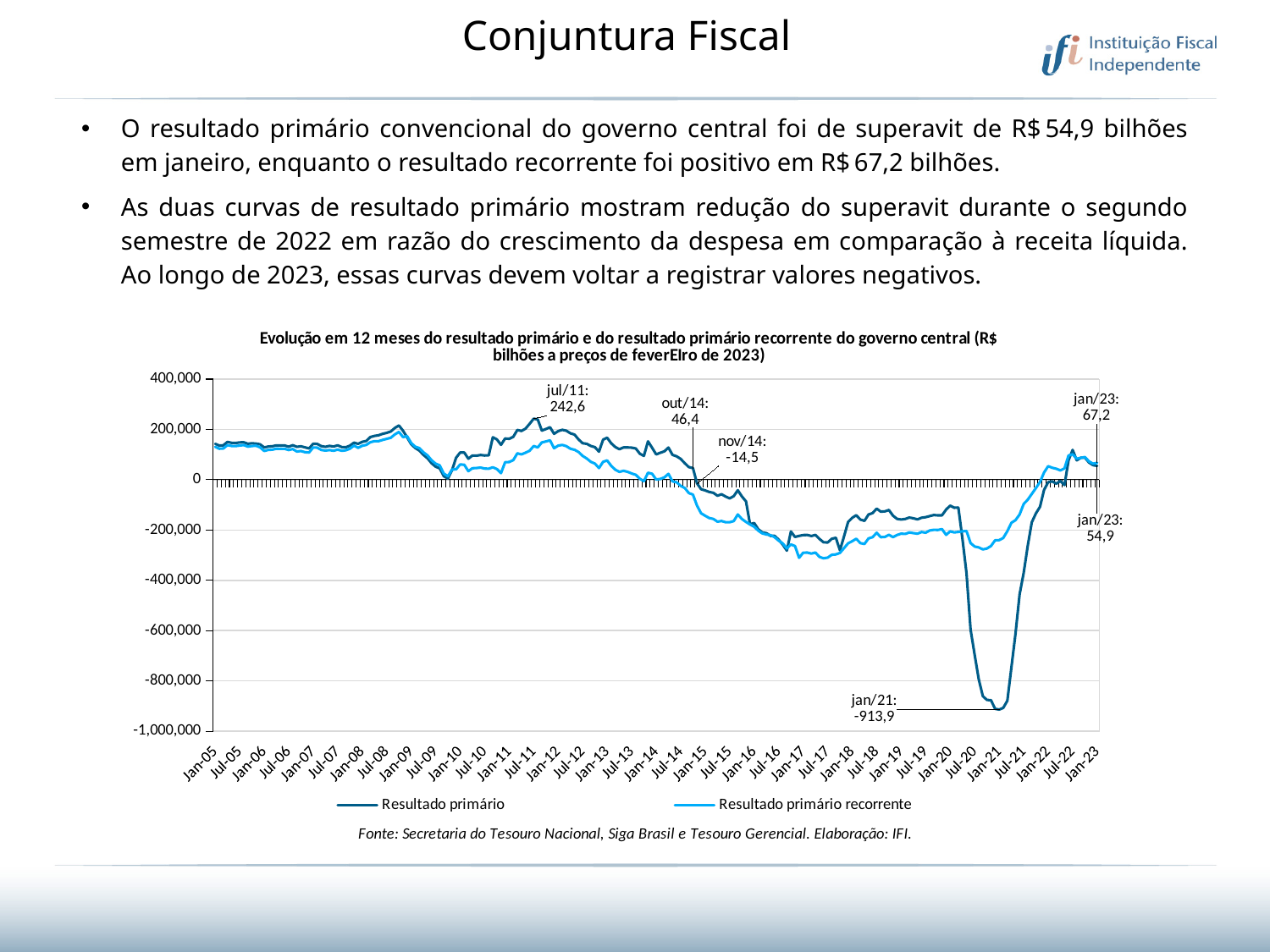
What is the difference between the two annotated jan/23 values (67,2 and 54,9)? 12,3 What value is annotated on the chart at jul/11? 242,6 What value is annotated on the chart at out/14? 46,4 What type of chart is shown on the slide? line chart What value is annotated on the chart at nov/14? -14,5 How many series does the chart legend list? 2 What value is annotated for Resultado primário at jan/23? 54,9 At jan/23, which series has the higher annotated value, Resultado primário or Resultado primário recorrente? Resultado primário recorrente What are the two series names shown in the chart legend? Resultado primário; Resultado primário recorrente Is the value of Resultado primário around Jan-21 greater or less than -800,000 on the axis? less What value is annotated for Resultado primário recorrente at jan/23? 67,2 What value is annotated on the chart at jan/21? -913,9